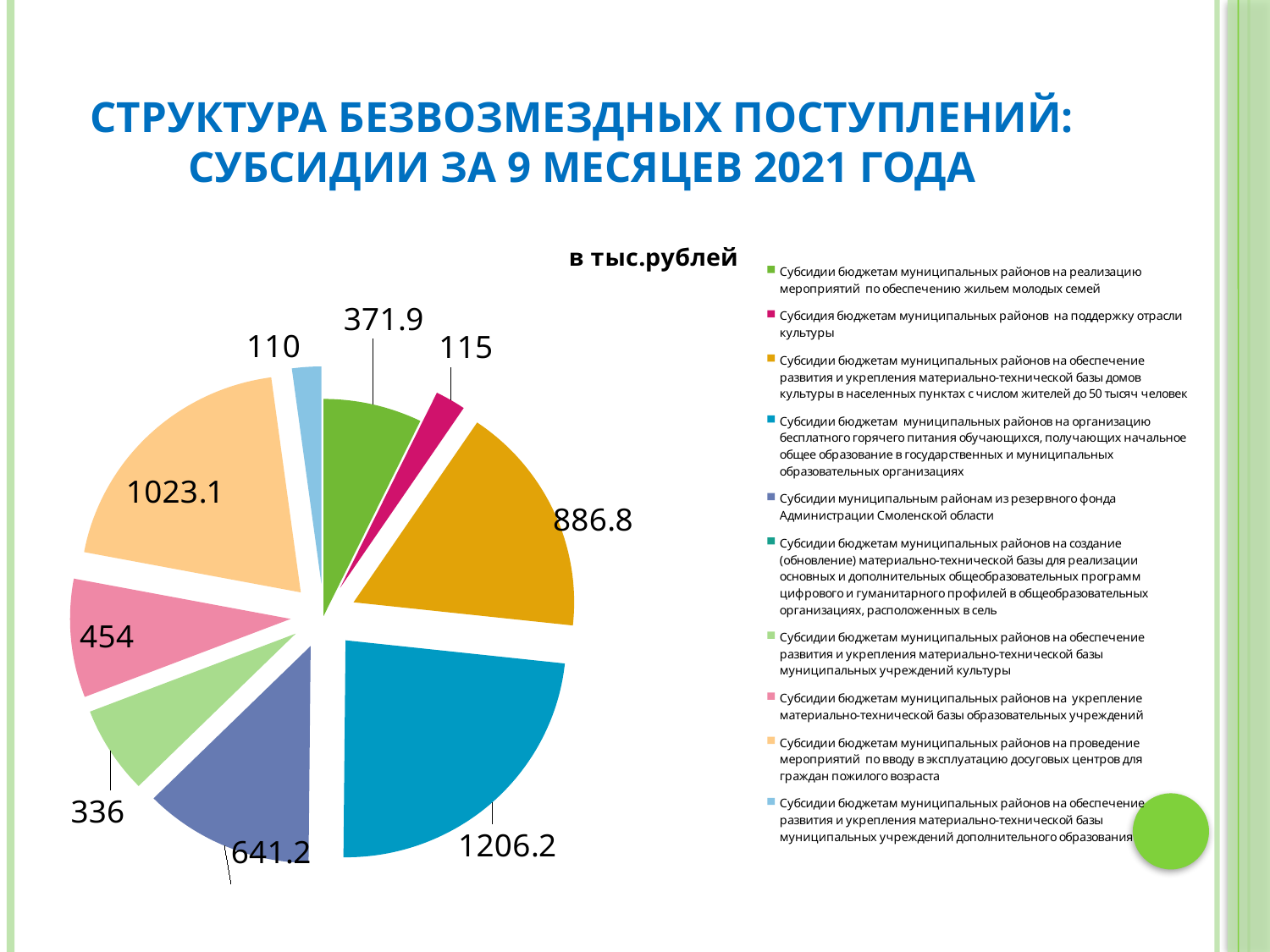
How many data labels are shown on the pie chart? 9 How many entries does the legend list? 10 What is the value of the slice for субсидии муниципальным районам из резервного фонда Администрации Смоленской области? 641.2 What is the difference between the largest slice (1206.2) and the slice for субсидии из резервного фонда (641.2)? 565 In what units are the values on the chart given, according to the label above the pie? в тыс.рублей Which is larger: the slice for укрепление материально-технической базы образовательных учреждений (454) or the slice for муниципальных учреждений культуры (336)? 454 (образовательных учреждений) What kind of chart is shown on the slide? pie chart What is the value of the slice for субсидия на поддержку отрасли культуры? 115 What is the value of the slice for субсидии на реализацию мероприятий по обеспечению жильем молодых семей? 371.9 Which slice of the pie chart has the smallest value? 110 (субсидии на обеспечение развития и укрепления материально-технической базы муниципальных учреждений дополнительного образования) Which slice of the pie chart has the largest value? 1206.2 (субсидии на организацию бесплатного горячего питания обучающихся) What is the value of the slice for субсидии на проведение мероприятий по вводу в эксплуатацию досуговых центров для граждан пожилого возраста? 1023.1